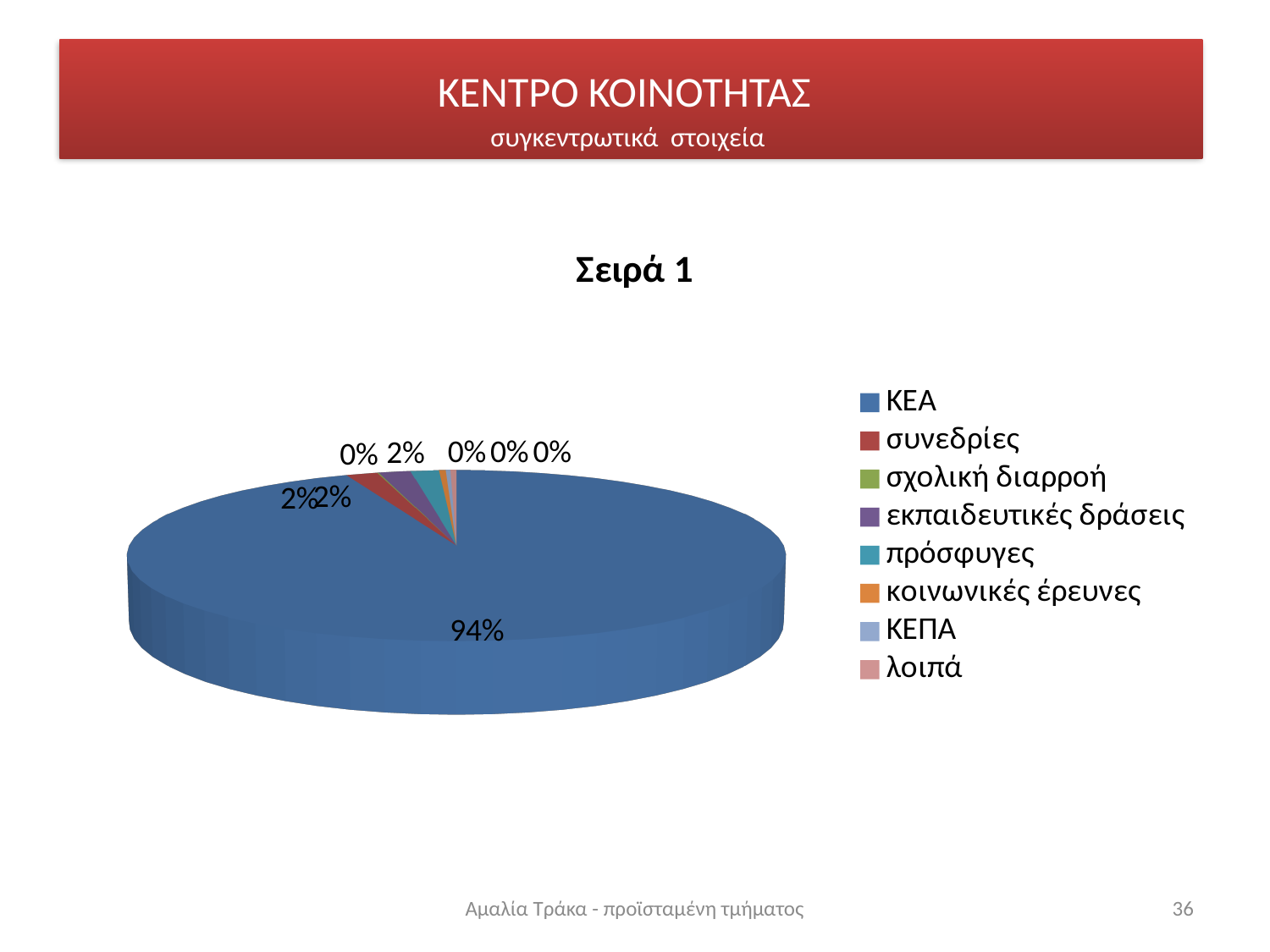
Which is larger in the pie chart, ΚΕΑ or συνεδρίες? ΚΕΑ Which category has the largest slice in the pie chart? ΚΕΑ What percentage of the pie chart does ΚΕΑ account for? 94% How many categories does the legend of the pie chart list? 8 What kind of chart is shown on the slide? Pie chart How many slices in the pie chart are labelled 0%? 4 How many slices in the pie chart are labelled 2%? 3 Which category is listed last in the legend of the pie chart? λοιπά What is the title of the chart? Σειρά 1 Which colour represents ΚΕΑ in the pie chart? Blue